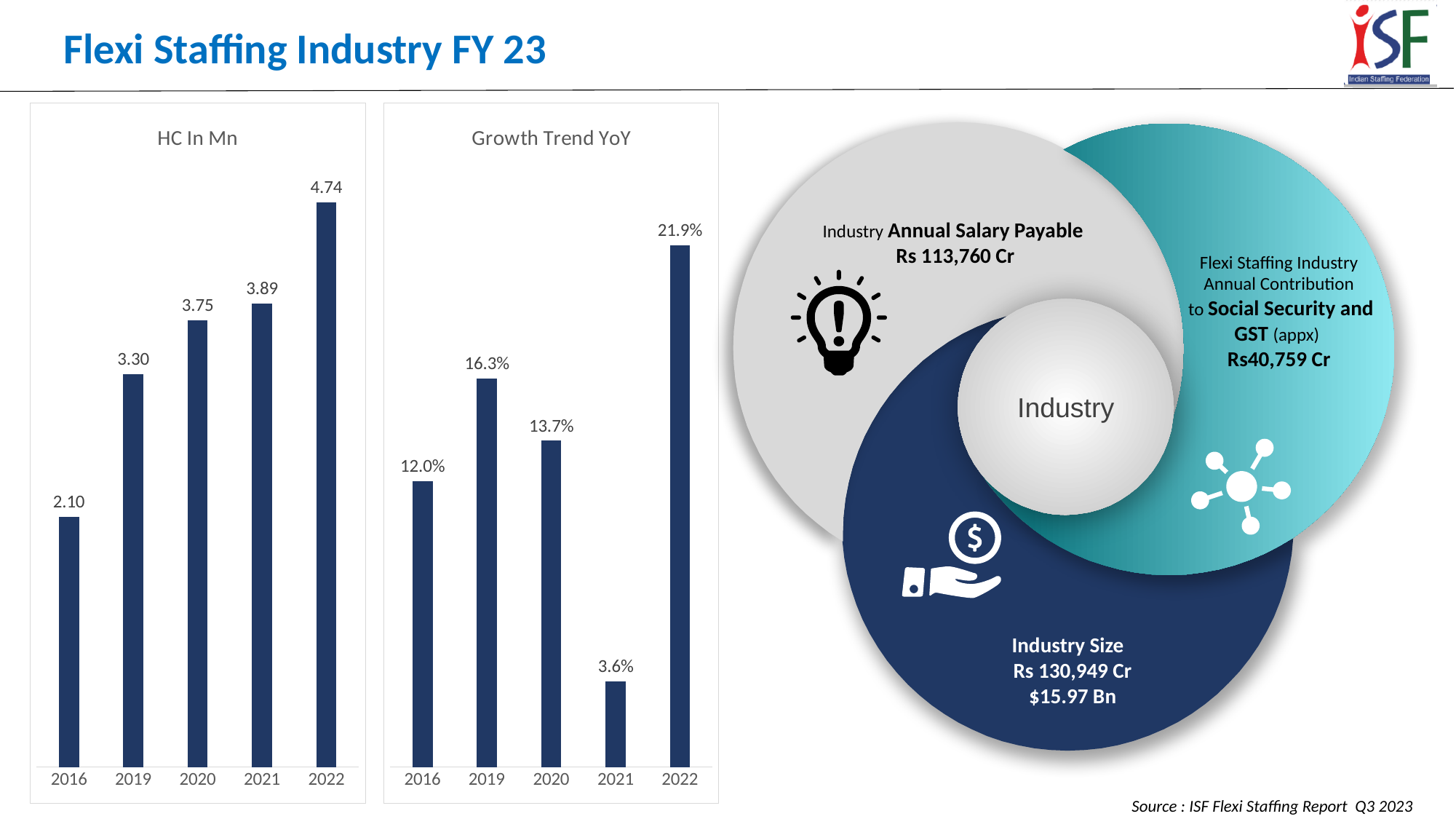
In the 'Growth Trend YoY' chart, what is the difference between the values for 2019 and 2020? 2.6% In the 'Growth Trend YoY' chart, which year has the highest value? 2022 How many years are shown on the x axis of the 'HC In Mn' chart? 5 In the 'HC In Mn' chart, what is the value for 2022? 4.74 In the 'Growth Trend YoY' chart, which is larger, the value for 2016 or the value for 2020? 2020 In the 'HC In Mn' chart, what is the difference between the values for 2022 and 2021? 0.85 In the 'Growth Trend YoY' chart, what is the value for 2019? 16.3% What kind of chart is the 'Growth Trend YoY' chart? Bar chart In the 'Growth Trend YoY' chart, which year has the lowest value? 2021 In the 'Growth Trend YoY' chart, what is the value for 2021? 3.6% In the 'HC In Mn' chart, which year has the lowest value? 2016 In the 'HC In Mn' chart, what is the value for 2016? 2.10